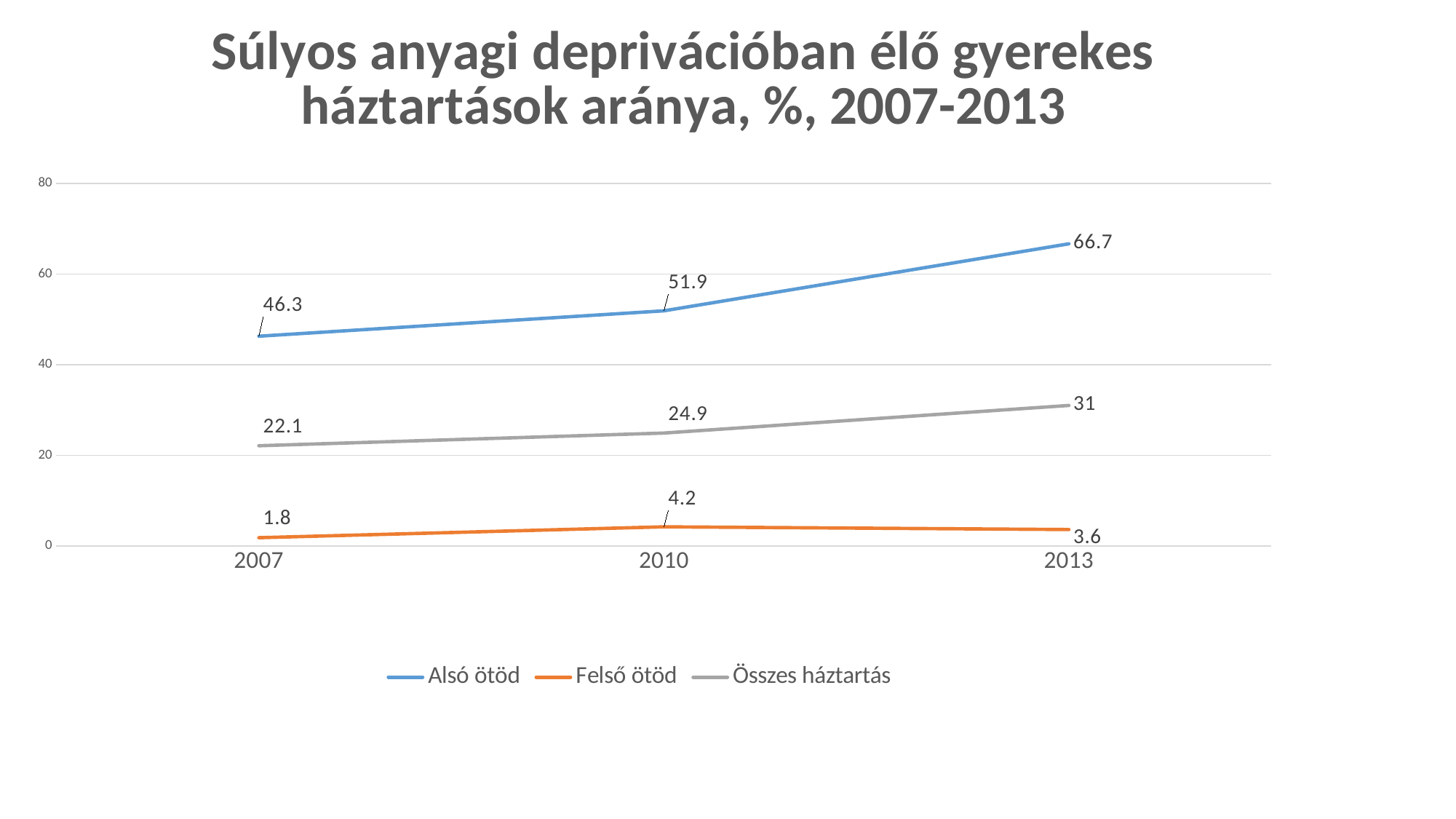
What kind of chart is shown on the slide? line chart What is the value for Felső ötöd in 2010? 4.2 What is the value for Alsó ötöd in 2013? 66.7 How many series does the legend list? 3 Is the value for Alsó ötöd in 2013 greater or less than 60? greater Does the Összes háztartás series rise or fall from 2007 to 2013? rise How many years are shown on the x axis? 3 In which year is the Felső ötöd series lowest? 2007 Which is larger in 2010: Alsó ötöd or Összes háztartás? Alsó ötöd In which year is the Alsó ötöd series highest? 2013 What is the difference between the Alsó ötöd values in 2013 and 2007? 20.4 What is the value for Összes háztartás in 2007? 22.1